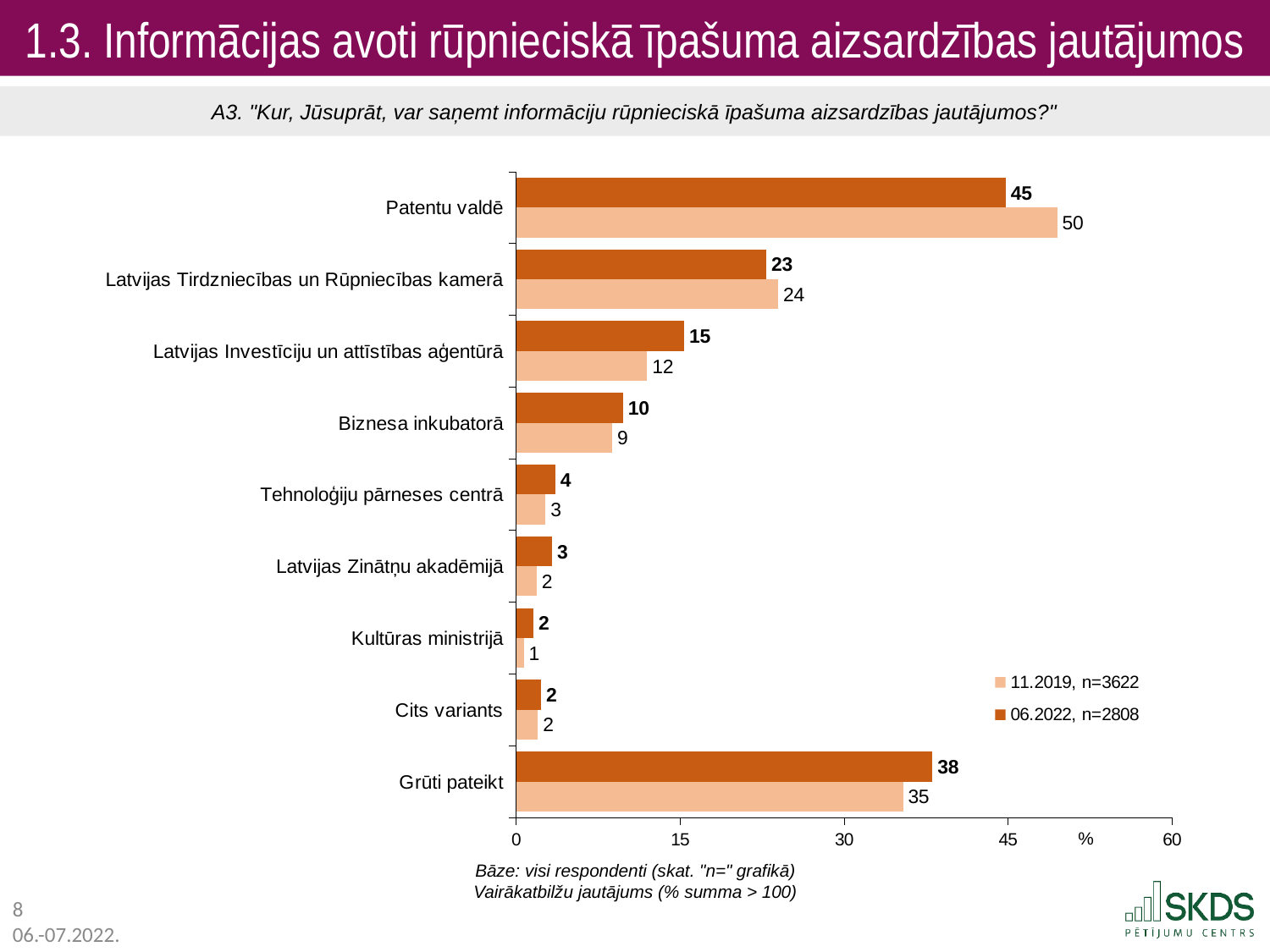
What is the sample size (n) for the 06.2022 series according to the legend? 2808 What is the value for Latvijas Tirdzniecības un Rūpniecības kamerā in the 11.2019, n=3622 series? 24 Which category has the lowest value in the 11.2019, n=3622 series? Kultūras ministrijā Is the 06.2022 value for Grūti pateikt greater or less than 30? greater How many series does the legend list? 2 What is the value for Grūti pateikt in the 06.2022, n=2808 series? 38 Which is larger for Latvijas Investīciju un attīstības aģentūrā: the 11.2019 value or the 06.2022 value? 06.2022 What is the difference between the 11.2019 and 06.2022 values for Patentu valdē? 5 What is the value for Patentu valdē in the 06.2022, n=2808 series? 45 Which category has the highest value in the 11.2019, n=3622 series? Patentu valdē What kind of chart is shown on the slide? bar chart How many categories are shown on the chart? 9